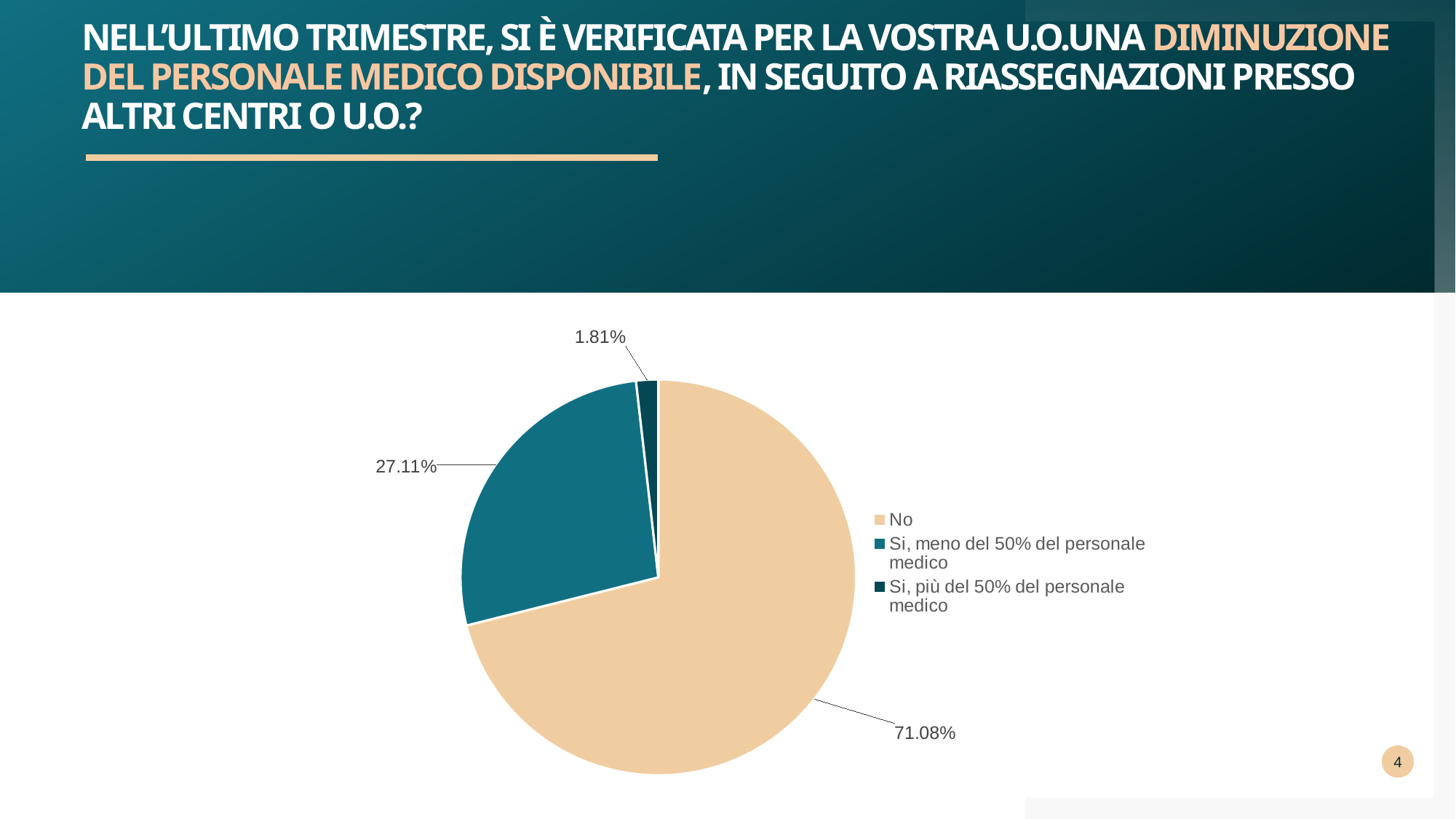
What percentage of the pie corresponds to "No"? 71.08% What is the difference in percentage points between "No" and "Si, meno del 50% del personale medico"? 43.97 Which is larger: the share for "Si, meno del 50% del personale medico" or the share for "Si, più del 50% del personale medico"? Si, meno del 50% del personale medico Which category has the smallest share of the pie? Si, più del 50% del personale medico What colour is the slice for "No"? beige What percentage of the pie corresponds to "Si, meno del 50% del personale medico"? 27.11% How many slices does the pie chart have? 3 What percentage of the pie corresponds to "Si, più del 50% del personale medico"? 1.81% How many entries does the legend list? 3 What is the combined percentage of the two "Si" categories? 28.92% Which category has the largest share of the pie? No What kind of chart is shown on the slide? pie chart